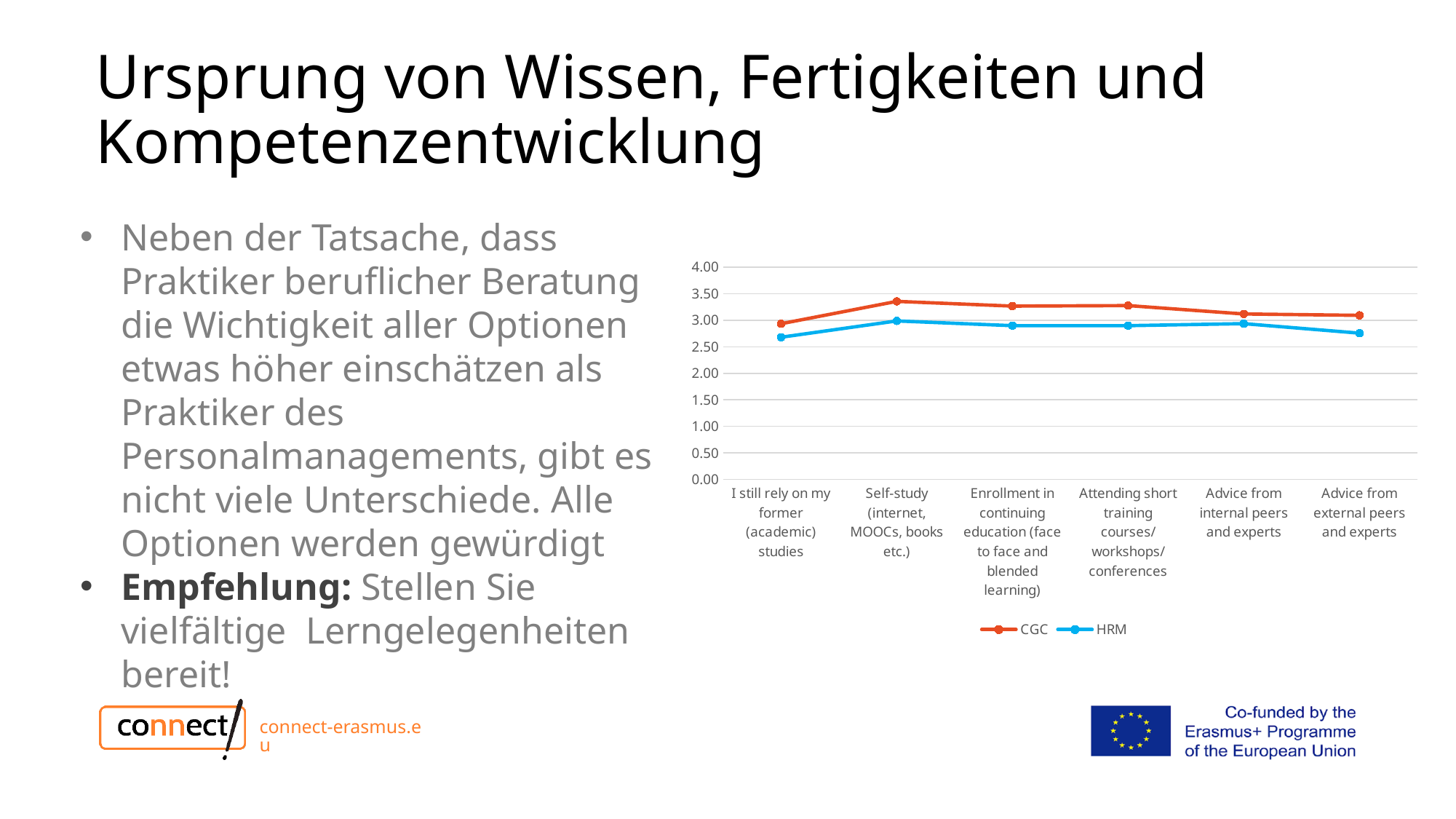
Is the CGC value for 'Attending short training courses/workshops/conferences' greater or less than 3.50? less Which colour is used for the HRM series in the chart? blue How many categories are shown on the x axis of the chart? 6 What kind of chart is shown on the slide? line chart Which series has the higher value for 'Advice from external peers and experts', CGC or HRM? CGC Is the CGC value for 'Self-study (internet, MOOCs, books etc.)' greater or less than 3.00? greater For which category does the CGC series have its lowest value? I still rely on my former (academic) studies How many series does the chart's legend list? 2 For which category does the CGC series reach its highest value? Self-study (internet, MOOCs, books etc.) For which category does the HRM series reach its highest value? Self-study (internet, MOOCs, books etc.) Which series has the higher value for 'I still rely on my former (academic) studies', CGC or HRM? CGC Is the HRM value for 'I still rely on my former (academic) studies' greater or less than 3.00? less